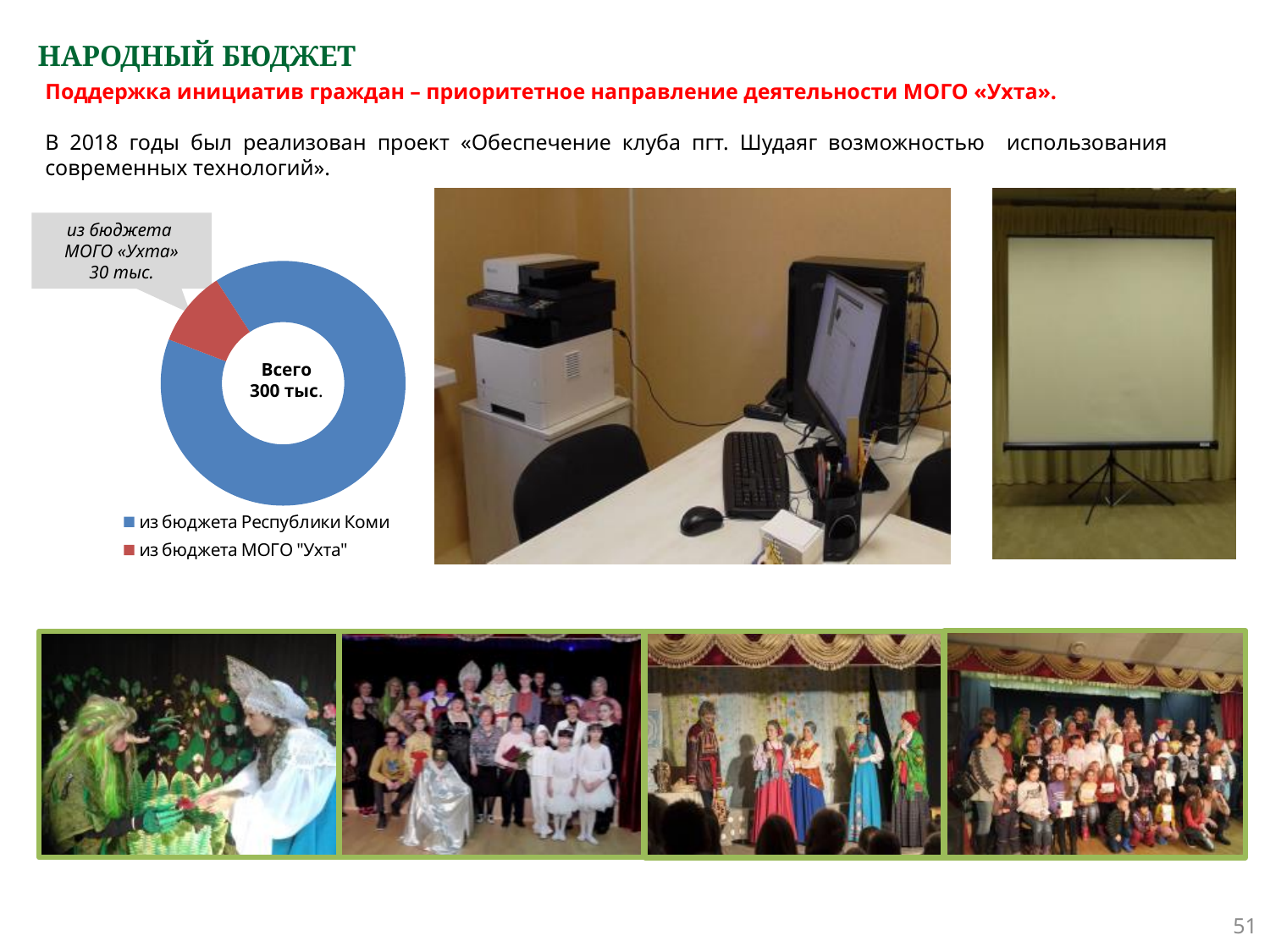
Which funding source accounts for the smallest slice of the chart? из бюджета МОГО "Ухта" What colour is the slice for the budget of МОГО «Ухта»? red What amount comes from the budget of МОГО «Ухта» according to the chart callout? 30 тыс. What colour is the slice for the budget of the Republic of Komi? blue Which is larger: the share from the budget of the Republic of Komi or the share from the budget of МОГО «Ухта»? из бюджета Республики Коми Which funding source accounts for the largest slice of the chart? из бюджета Республики Коми How many categories does the legend of the chart list? 2 Given the total of 300 тыс. and 30 тыс. from МОГО «Ухта», how much comes from the budget of the Republic of Komi? 270 тыс. What kind of chart is shown on the slide? doughnut (pie) chart What is the total amount shown in the centre of the doughnut chart? 300 тыс. What share of the total 300 тыс. does the 30 тыс. from the budget of МОГО «Ухта» represent? 10%